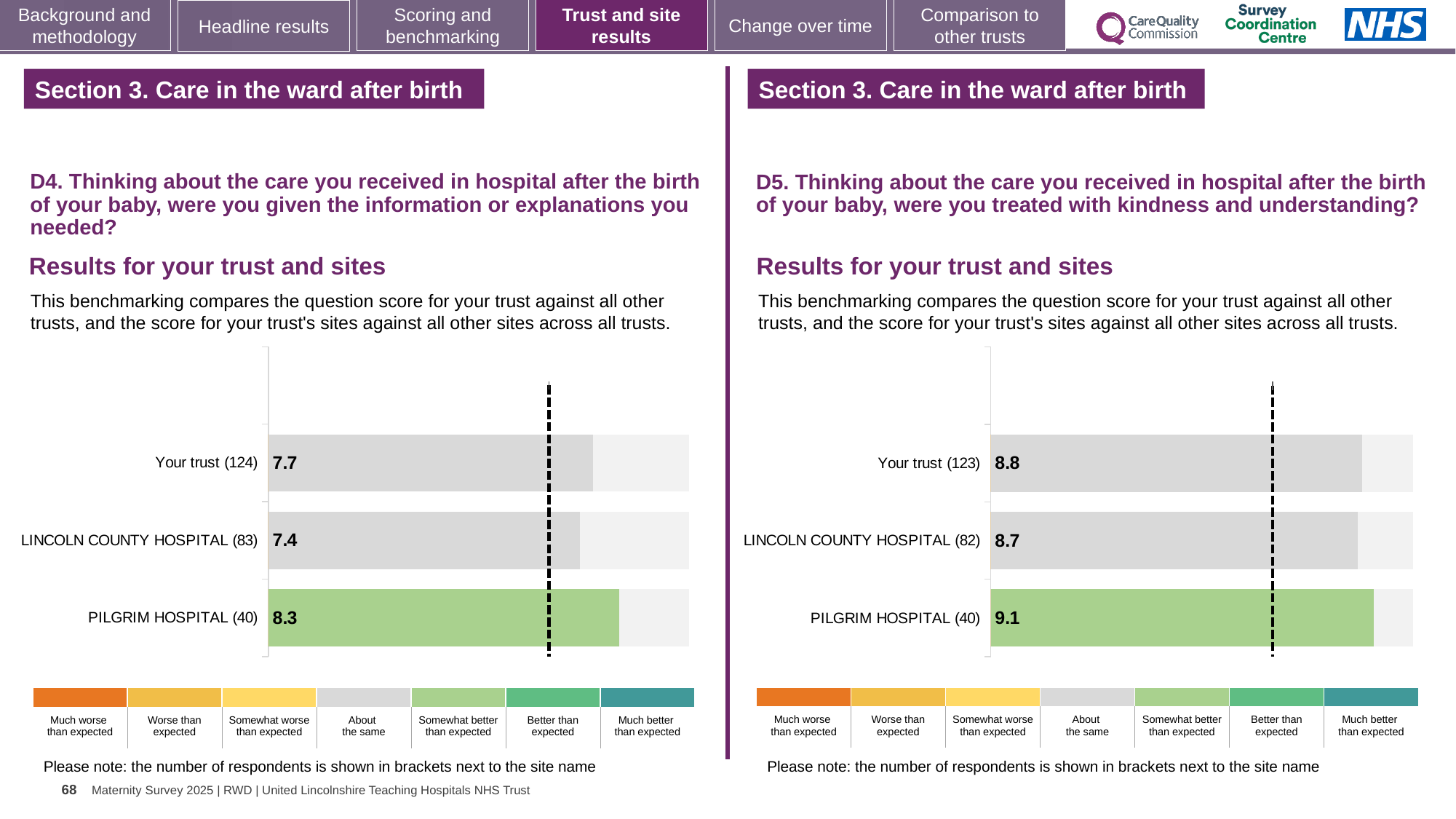
In the D5 chart on the right, what is the score for PILGRIM HOSPITAL? 9.1 In the D4 chart on the left, which site or trust has the lowest score? LINCOLN COUNTY HOSPITAL In the D5 chart on the right, what is the score for Your trust? 8.8 In the D4 chart on the left, what is the difference between the scores for PILGRIM HOSPITAL and LINCOLN COUNTY HOSPITAL? 0.9 In the D4 chart on the left, what is the score for Your trust? 7.7 In the D4 chart on the left, how many respondents are shown in brackets for PILGRIM HOSPITAL? 40 In the D5 chart on the right, what is the difference between the scores for PILGRIM HOSPITAL and Your trust? 0.3 What kind of chart is used in the D4 chart on the left? Bar chart In the D5 chart on the right, which site or trust has the lowest score? LINCOLN COUNTY HOSPITAL In the D5 chart on the right, how many bars are plotted? 3 In the D4 chart on the left, what is the score for LINCOLN COUNTY HOSPITAL? 7.4 In the D4 chart on the left, which site or trust has the highest score? PILGRIM HOSPITAL